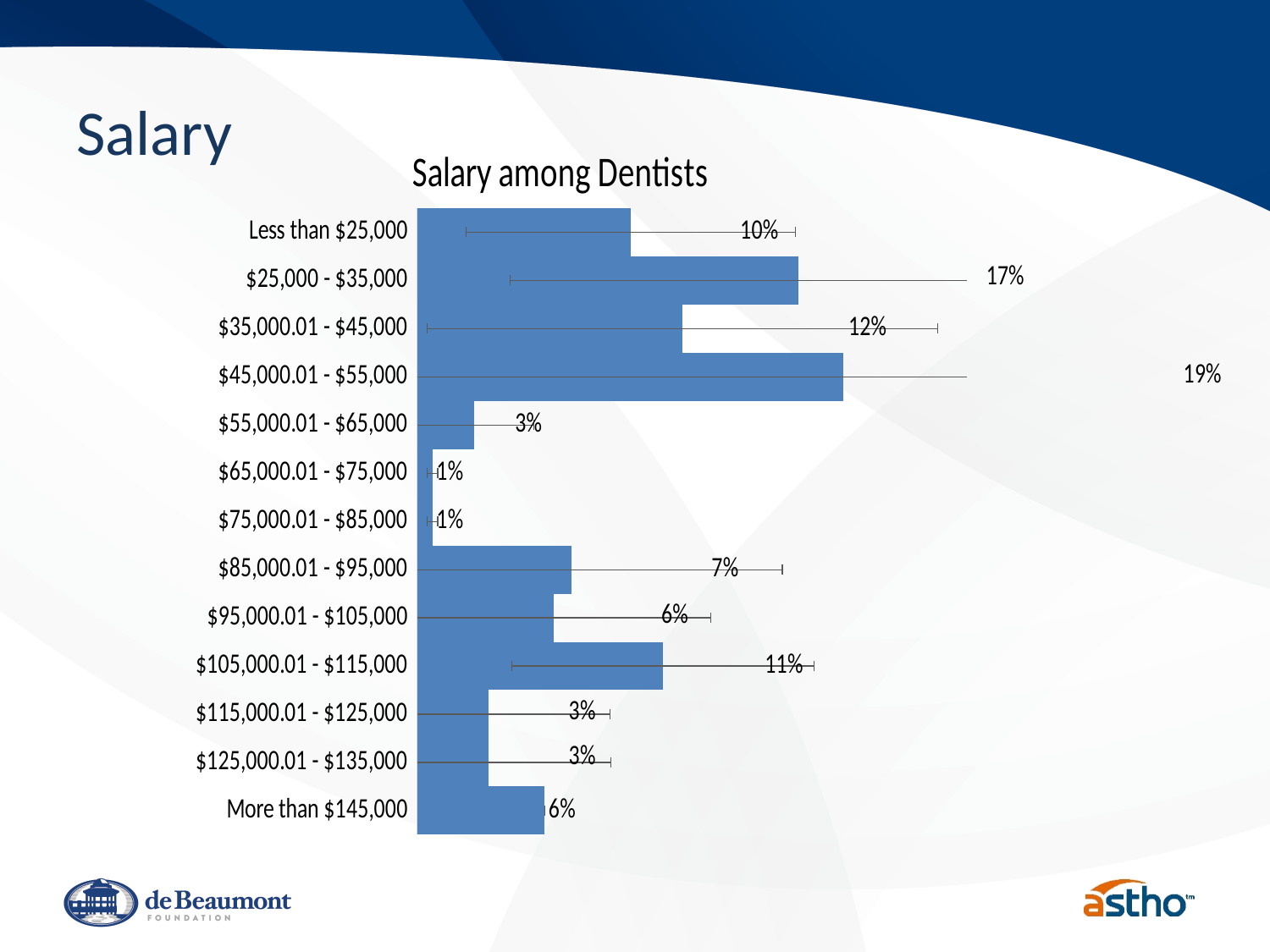
What is the difference between the percentage for $45,000.01 - $55,000 and the percentage for $25,000 - $35,000? 2% What is the title of the chart? Salary among Dentists Which salary category has the highest percentage of dentists? $45,000.01 - $55,000 What is the difference between the percentage for $35,000.01 - $45,000 and the percentage for $55,000.01 - $65,000? 9% What percentage of dentists earn $45,000.01 - $55,000? 19% What type of chart is shown on the slide? Bar chart How many salary categories are shown in the chart? 13 What is the lowest percentage shown in the chart? 1% What percentage of dentists earn more than $145,000? 6% What percentage of dentists earn $25,000 - $35,000? 17% What percentage of dentists earn $105,000.01 - $115,000? 11% Which is larger: the percentage for Less than $25,000 or the percentage for $85,000.01 - $95,000? Less than $25,000